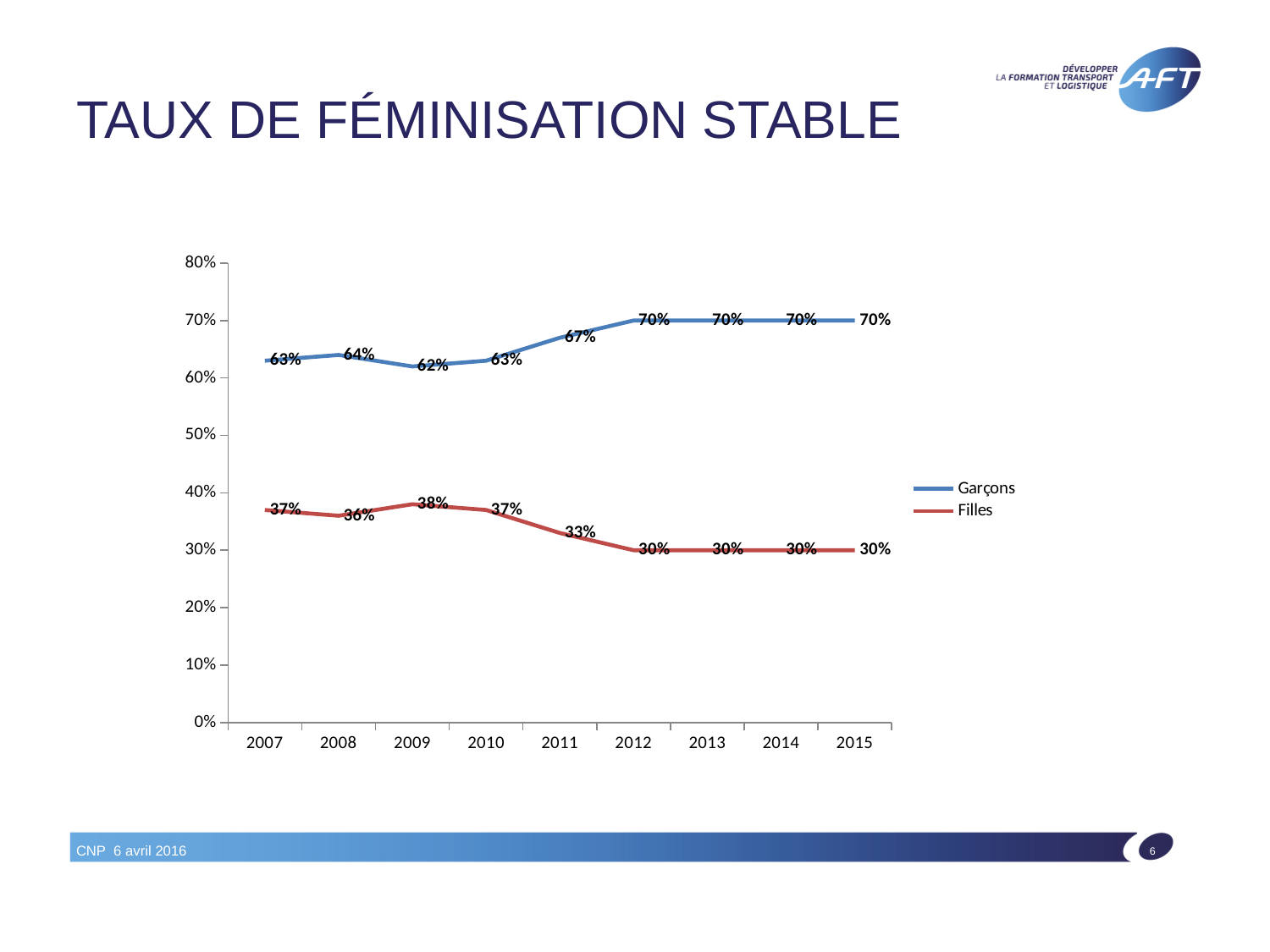
How many years are shown on the x axis? 9 What is the value for Filles in 2009? 38% Is the value for Filles in 2011 greater or less than 40%? less Does the Filles series rise or fall from 2010 to 2012? fall What kind of chart is shown on the slide? line chart In which year is the Filles series at its highest? 2009 How many series does the legend list? 2 What is the value for Garçons in 2011? 67% What is the value for Filles in 2015? 30% In which year is the Garçons series at its lowest? 2009 Which series has the larger value in 2008, Garçons or Filles? Garçons What is the difference between the Garçons and Filles values in 2012? 40%